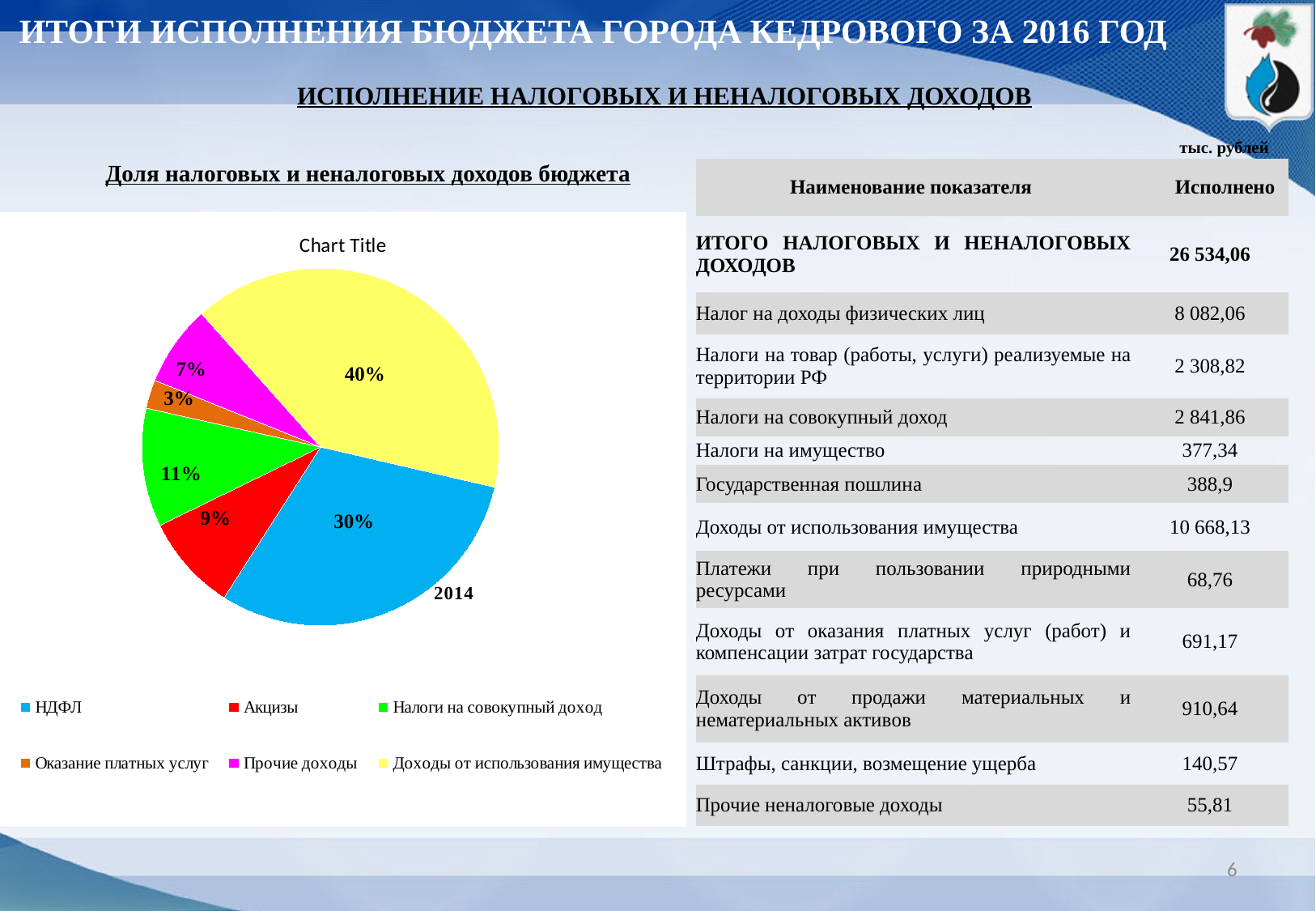
What share of the pie does "НДФЛ" have? 30% What share of the pie does "Оказание платных услуг" have? 3% What share of the pie does "Доходы от использования имущества" have? 40% Which category has the largest slice of the pie? Доходы от использования имущества What share of the pie does "Прочие доходы" have? 7% What is the difference in percentage points between the "Доходы от использования имущества" slice and the "НДФЛ" slice? 10% Which category has the smallest slice of the pie? Оказание платных услуг What share of the pie does "Налоги на совокупный доход" have? 11% How many entries does the legend of the pie chart list? 6 What type of chart is shown on the slide? pie chart Which slice is larger, "Налоги на совокупный доход" or "Акцизы"? Налоги на совокупный доход What share of the pie does "Акцизы" have? 9%